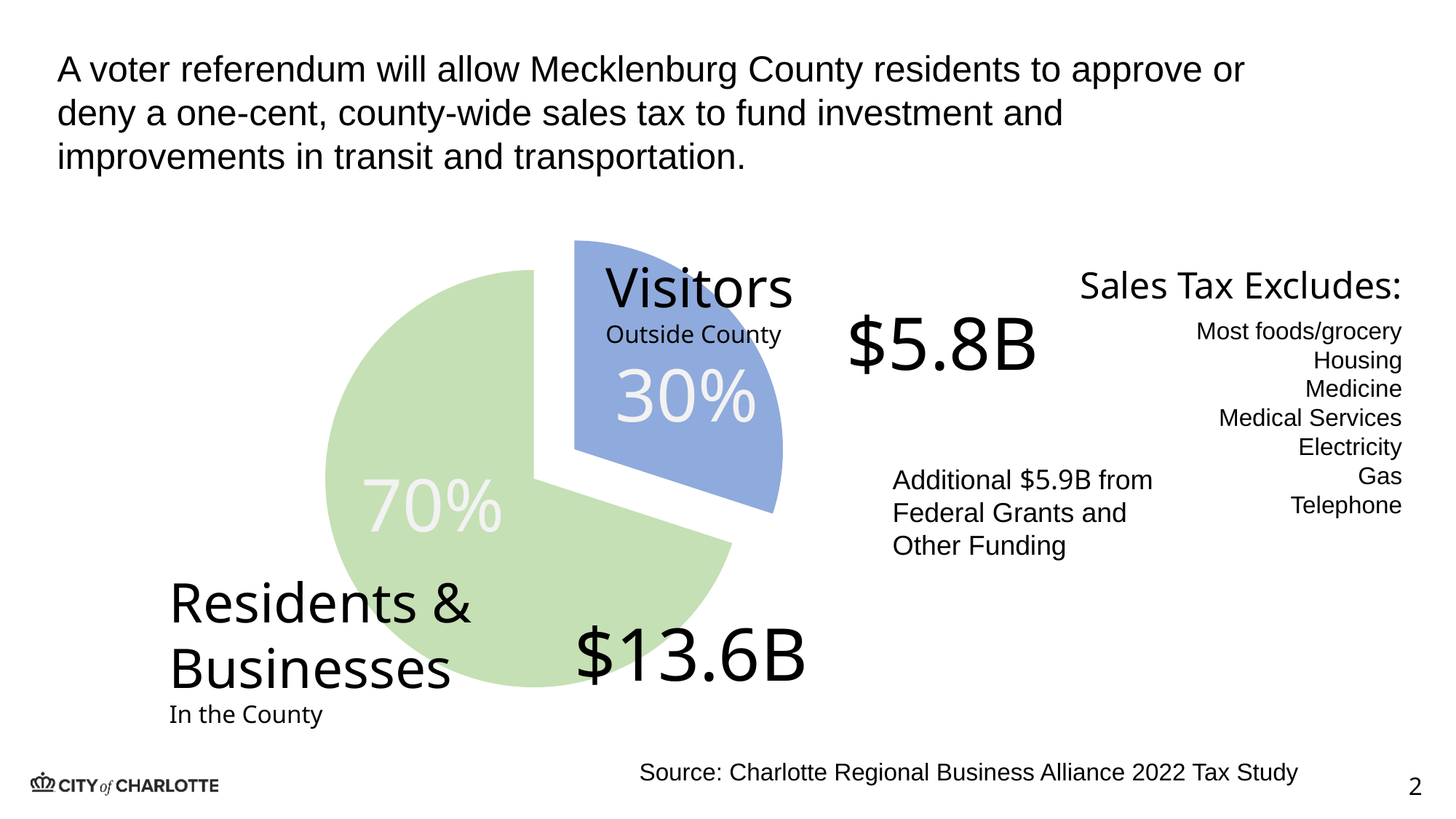
How many slices does the pie chart have? 2 What dollar amount is shown for the Residents & Businesses slice? $13.6B Which is larger, the Visitors share or the Residents & Businesses share? Residents & Businesses What colour is the Visitors slice of the pie? Blue Which slice of the pie is the largest? Residents & Businesses What dollar amount is shown for the Visitors slice? $5.8B Which slice of the pie is the smallest? Visitors What share of the pie does the Visitors slice represent? 30% What colour is the Residents & Businesses slice of the pie? Green What share of the pie does the Residents & Businesses slice represent? 70% What is the difference in percentage points between the Residents & Businesses share and the Visitors share? 40 percentage points What kind of chart is shown on the slide? Pie chart